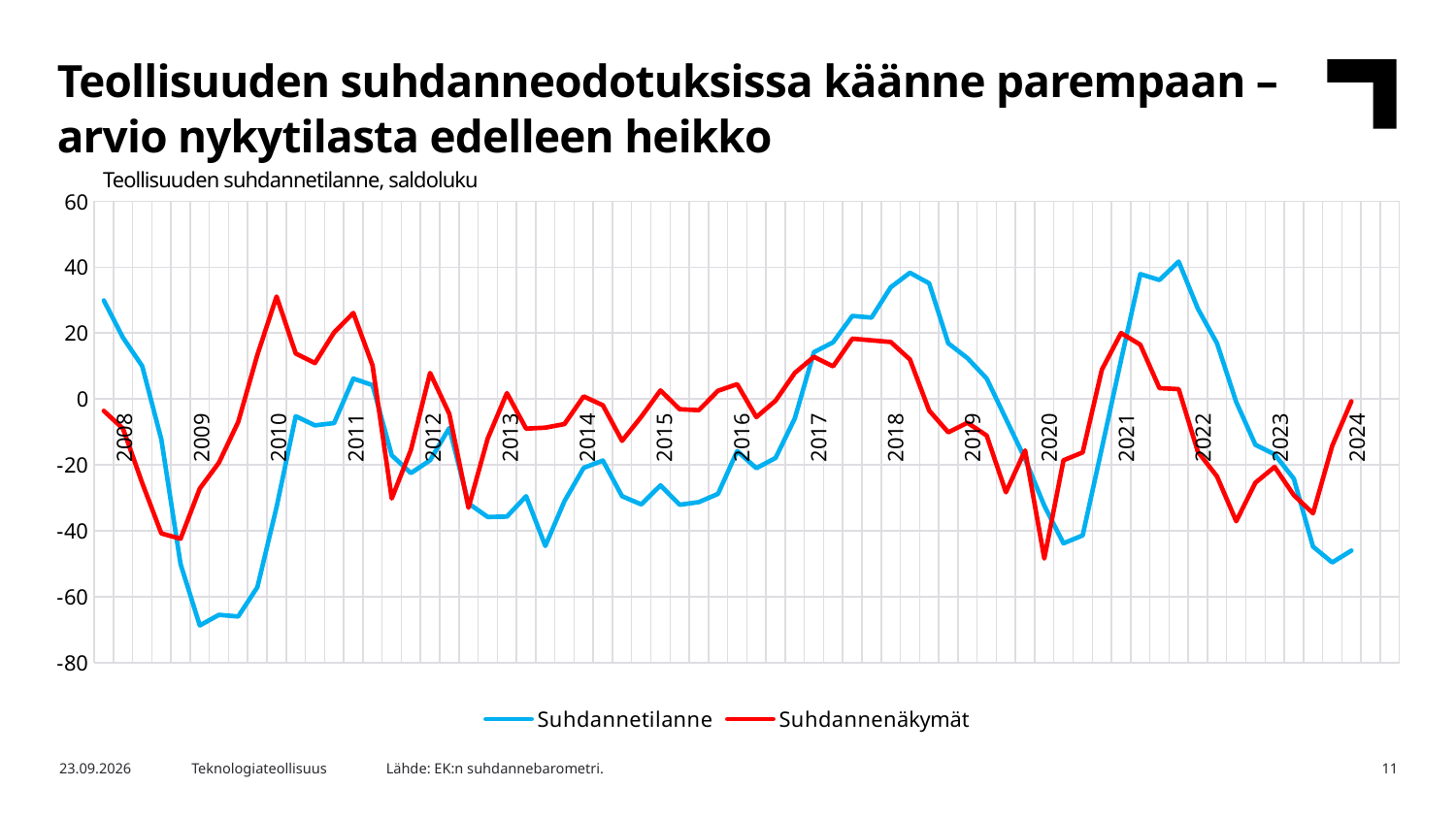
Is the value for Suhdannenäkymät at the 2024 tick greater or less than -20? greater Is the value for Suhdannenäkymät at the 2010 tick greater or less than 20? greater Is the value for Suhdannetilanne at the 2009 tick greater or less than -40? less Does the Suhdannetilanne line rise or fall between the 2021 and 2023 ticks? fall What is the title printed above the chart? Teollisuuden suhdannetilanne, saldoluku What are the two series named in the legend? Suhdannetilanne and Suhdannenäkymät What kind of chart is shown on the slide? line chart At the 2018 tick, which series has the higher value, Suhdannetilanne or Suhdannenäkymät? Suhdannetilanne At the 2009 tick, which series has the higher value, Suhdannetilanne or Suhdannenäkymät? Suhdannenäkymät How many year labels are shown on the x axis? 17 How many series does the legend list? 2